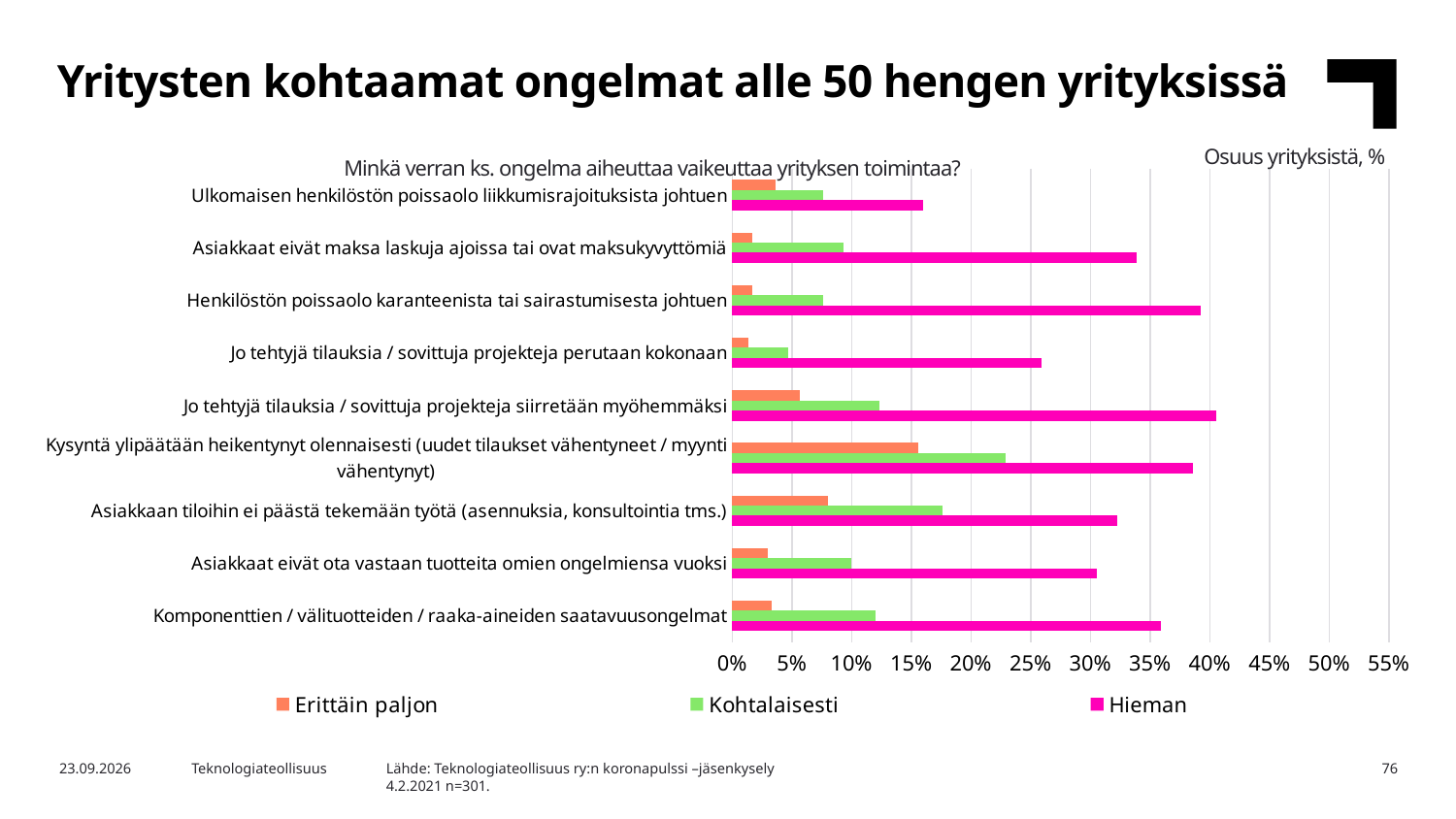
For 'Asiakkaan tiloihin ei päästä tekemään työtä', which series has the larger value: 'Kohtalaisesti' or 'Erittäin paljon'? Kohtalaisesti Which category has the highest value for the 'Erittäin paljon' series? Kysyntä ylipäätään heikentynyt olennaisesti (uudet tilaukset vähentyneet / myynti vähentynyt) Which category has the lowest value for the 'Kohtalaisesti' series? Jo tehtyjä tilauksia / sovittuja projekteja perutaan kokonaan How many series does the legend list? 3 What kind of chart is shown on the slide? bar chart Is the 'Kohtalaisesti' value for 'Kysyntä ylipäätään heikentynyt olennaisesti' greater or less than 20%? greater How many problem categories are plotted on the chart? 9 Which category has the highest value for the 'Kohtalaisesti' series? Kysyntä ylipäätään heikentynyt olennaisesti (uudet tilaukset vähentyneet / myynti vähentynyt) Which category has the lowest value for the 'Hieman' series? Ulkomaisen henkilöstön poissaolo liikkumisrajoituksista johtuen What are the three legend entries of the chart? Erittäin paljon, Kohtalaisesti, Hieman Is the 'Hieman' value for 'Asiakkaat eivät maksa laskuja ajoissa tai ovat maksukyvyttömiä' greater or less than 30%? greater Is the 'Hieman' value for 'Ulkomaisen henkilöstön poissaolo liikkumisrajoituksista johtuen' greater or less than 20%? less